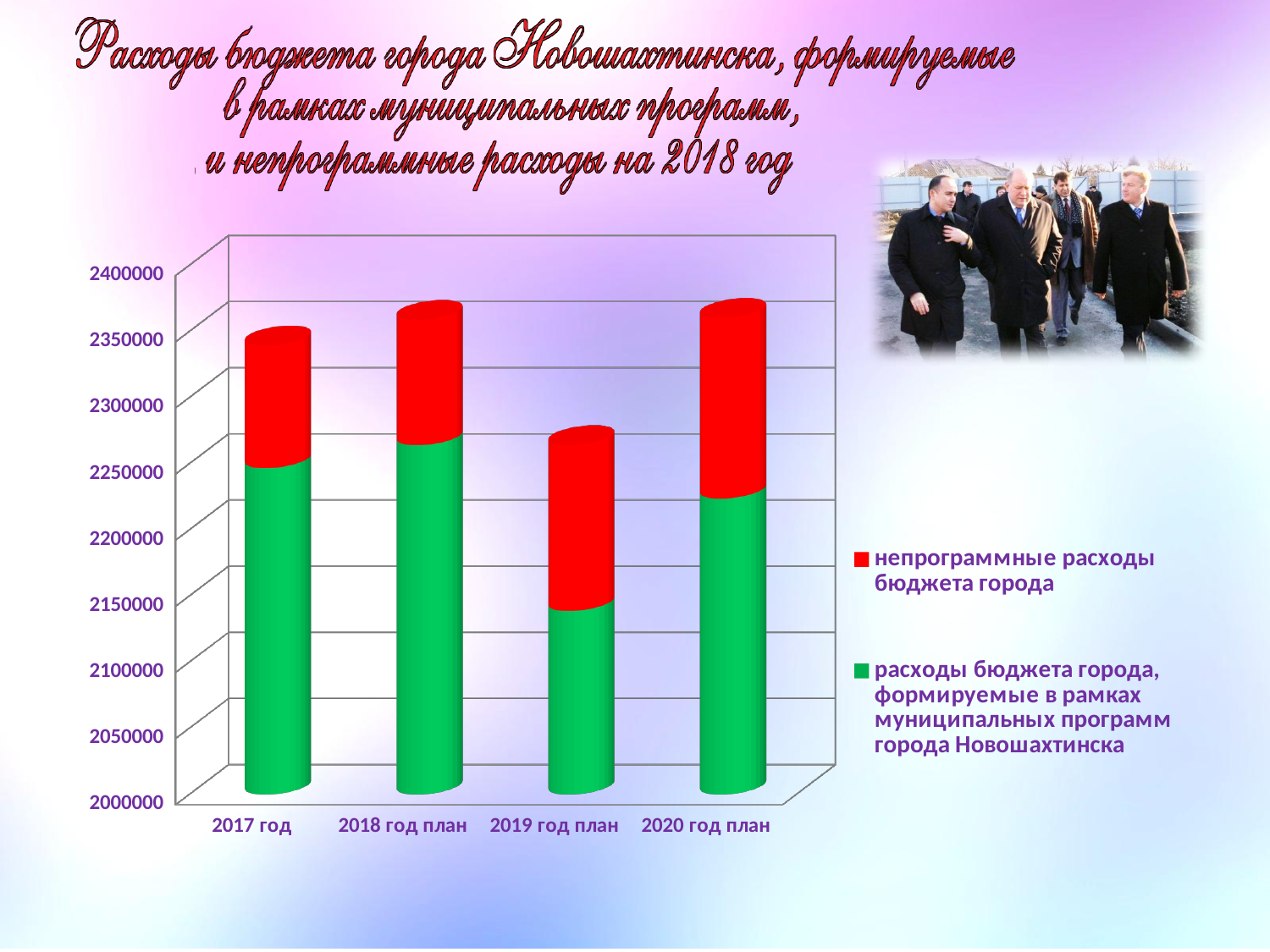
Is the value for 'расходы бюджета города, формируемые в рамках муниципальных программ города Новошахтинска' in 2020 год план greater or less than 2200000? greater Which year has the lowest value for 'расходы бюджета города, формируемые в рамках муниципальных программ города Новошахтинска'? 2019 год план Which year has the lowest total bar in the chart? 2019 год план Is the value for 'расходы бюджета города, формируемые в рамках муниципальных программ города Новошахтинска' in 2019 год план greater or less than 2200000? less Which has the larger total bar: 2017 год or 2019 год план? 2017 год Which year has the larger green segment ('расходы бюджета города, формируемые в рамках муниципальных программ города Новошахтинска'): 2019 год план or 2020 год план? 2020 год план How many series does the chart's legend list? 2 Which colour represents 'непрограммные расходы бюджета города' in the chart? red Is the total bar for 2019 год план greater or less than 2300000? less What kind of chart is shown on the slide? bar chart How many categories are shown on the x axis of the chart? 4